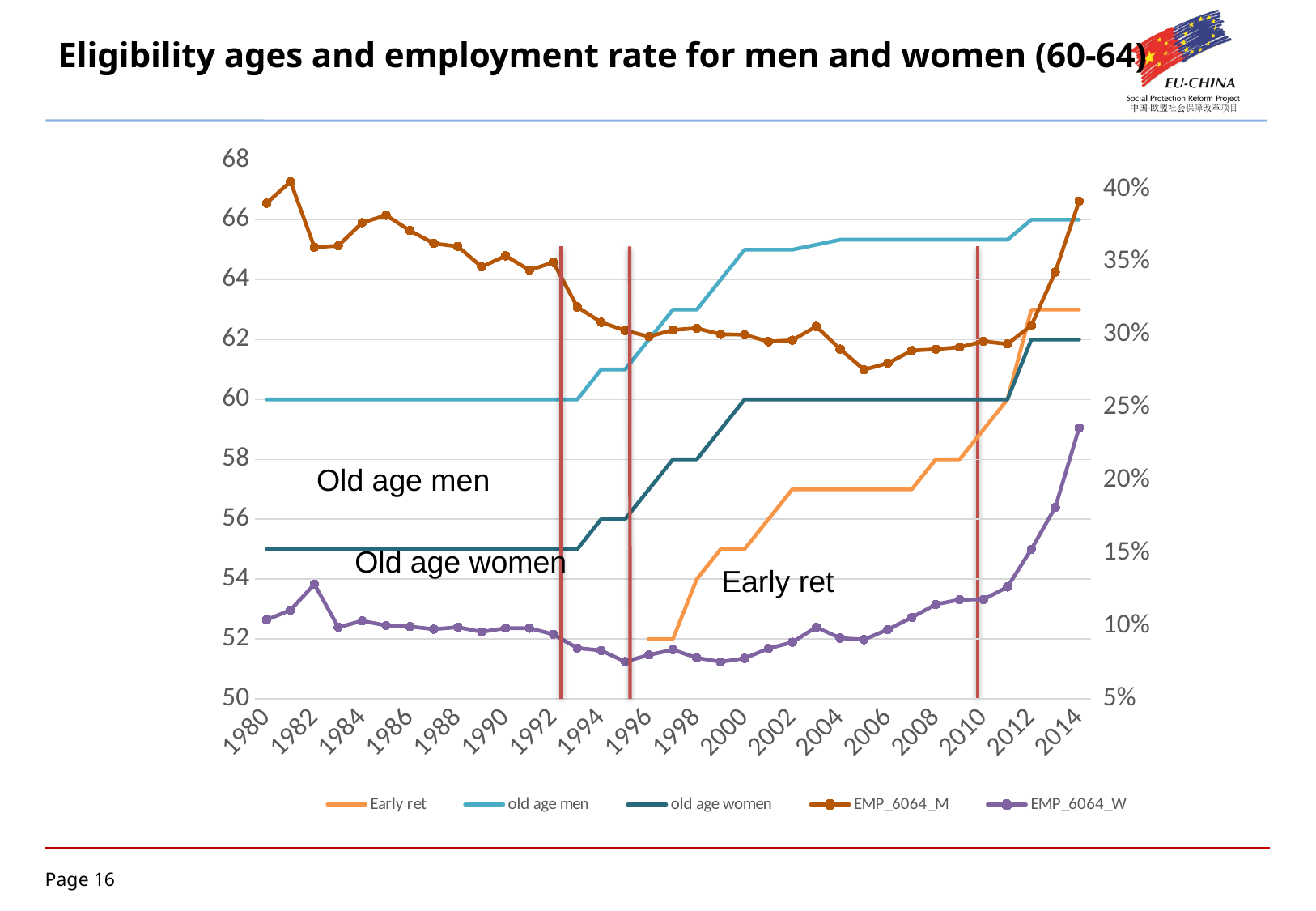
Is the value for EMP_6064_M in 1980 greater or less than 35%? greater What kind of chart is shown on the slide? line chart Is the value for EMP_6064_M in 2005 greater or less than 30%? less What is the value of the 'old age men' series in 1985? 60 Is the value for EMP_6064_W in 1999 greater or less than 10%? less What is the value of the 'old age men' series in 2014? 66 What is the value of the 'old age women' series in 2005? 60 How many series does the legend list? 5 Does the EMP_6064_W series rise or fall between 2010 and 2014? rise How many red vertical lines are drawn on the chart? 3 What is the value of the 'old age women' series in 2014? 62 In 2014, which is larger: EMP_6064_M or EMP_6064_W? EMP_6064_M